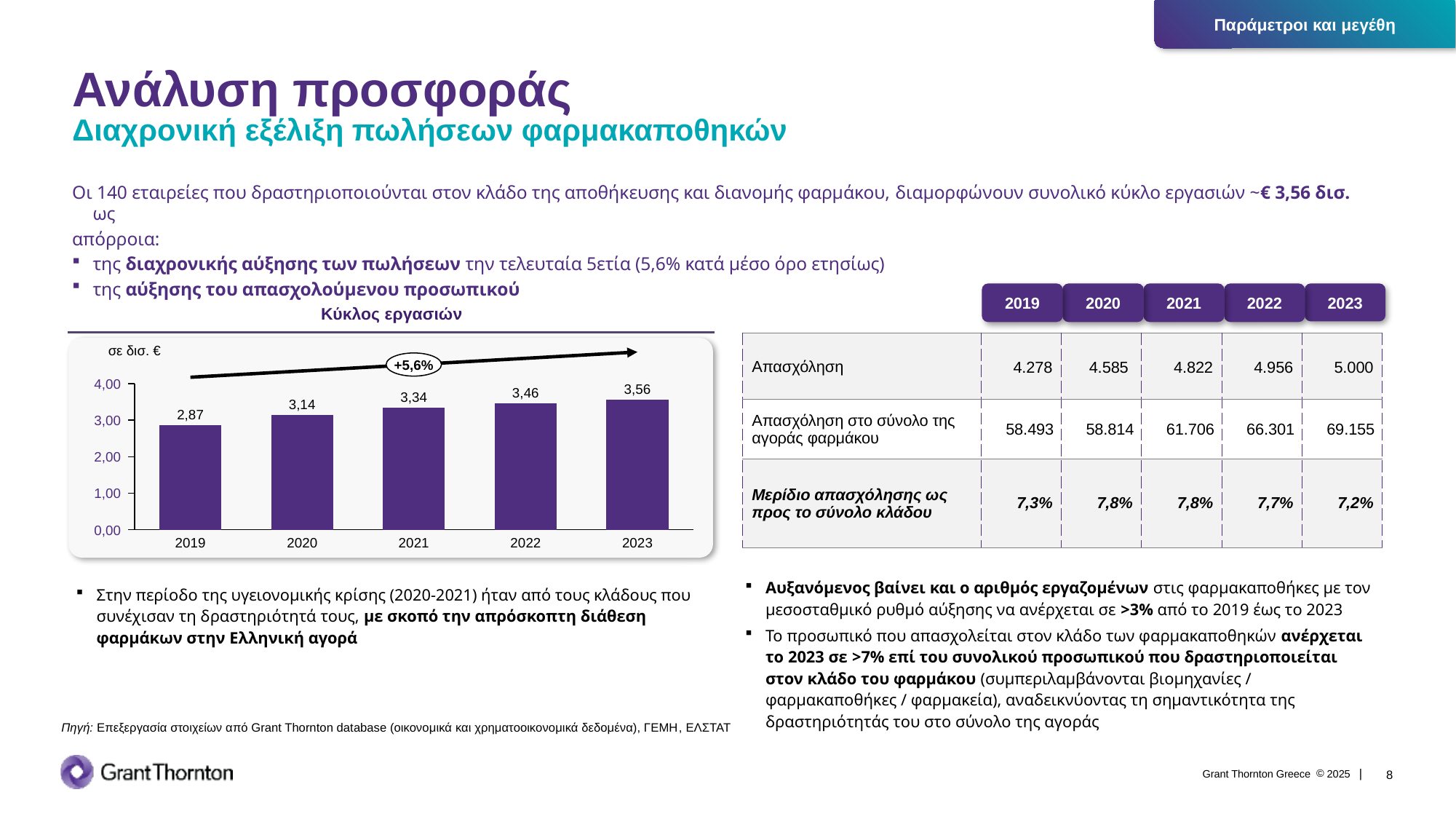
What kind of chart is the Κύκλος εργασιών chart? bar chart In the Κύκλος εργασιών chart, which is larger, the value for 2022 or the value for 2020? 2022 What is the value for 2023 in the Κύκλος εργασιών chart? 3,56 What is the difference between the 2023 and 2019 values in the Κύκλος εργασιών chart? 0,69 Do the values in the Κύκλος εργασιών chart rise or fall from 2019 to 2023? rise What is the value for 2019 in the Κύκλος εργασιών chart? 2,87 What is the value for 2021 in the Κύκλος εργασιών chart? 3,34 How many years are shown on the x axis of the Κύκλος εργασιών chart? 5 What is the difference between the 2020 and 2019 values in the Κύκλος εργασιών chart? 0,27 Is the value for 2019 in the Κύκλος εργασιών chart greater or less than 3,00? less Which year has the lowest value in the Κύκλος εργασιών chart? 2019 Which year has the highest value in the Κύκλος εργασιών chart? 2023